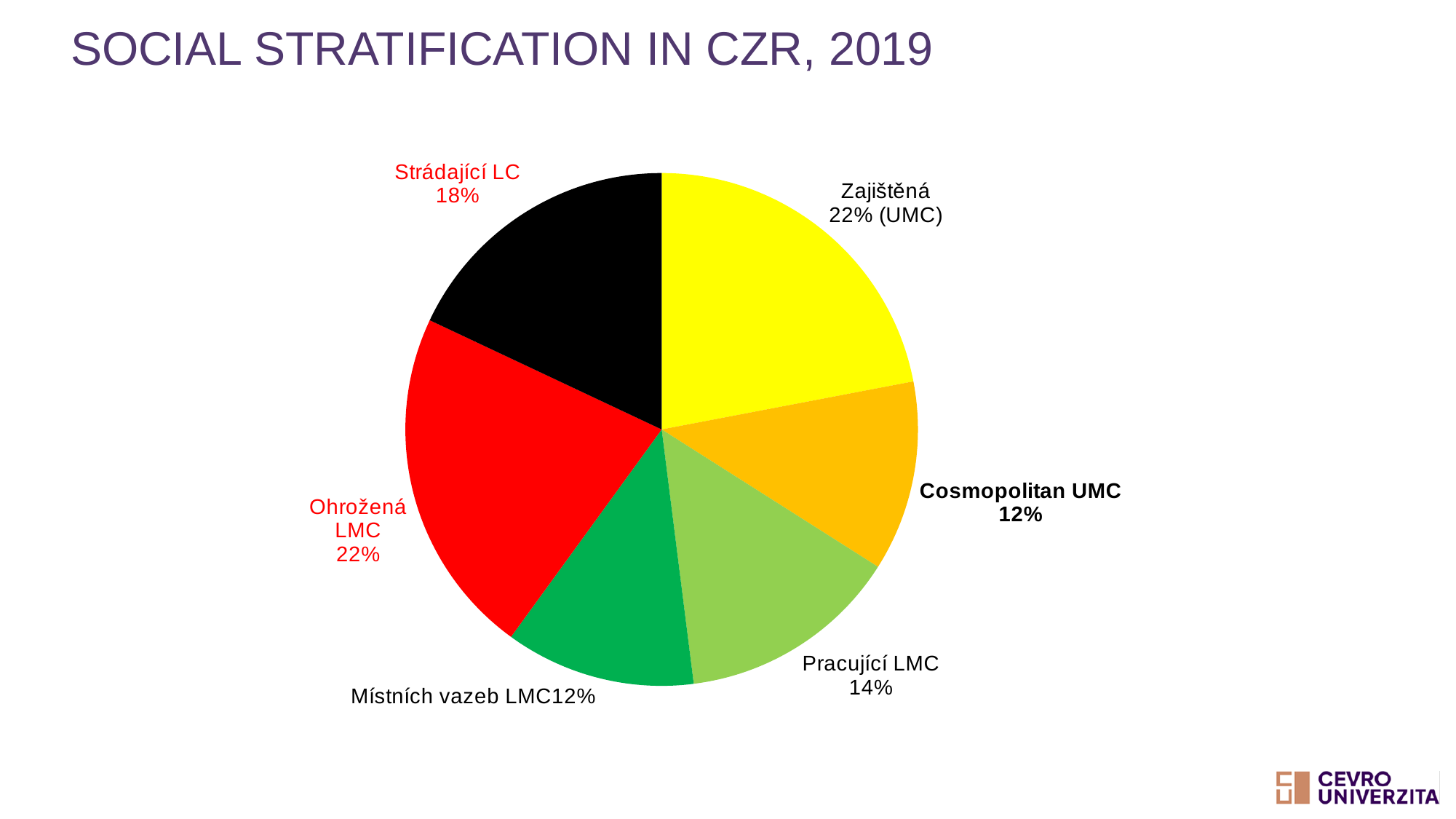
Which is larger, Strádající LC or Pracující LMC? Strádající LC What share of the pie is Cosmopolitan UMC? 12% What kind of chart is shown on the slide? Pie chart What share of the pie is Místních vazeb LMC? 12% What is the difference between the shares of Ohrožená LMC and Cosmopolitan UMC? 10% What share of the pie is Pracující LMC? 14% What colour is the Strádající LC slice? Black How many slices does the pie chart have? 6 What is the title of the chart on the slide? SOCIAL STRATIFICATION IN CZR, 2019